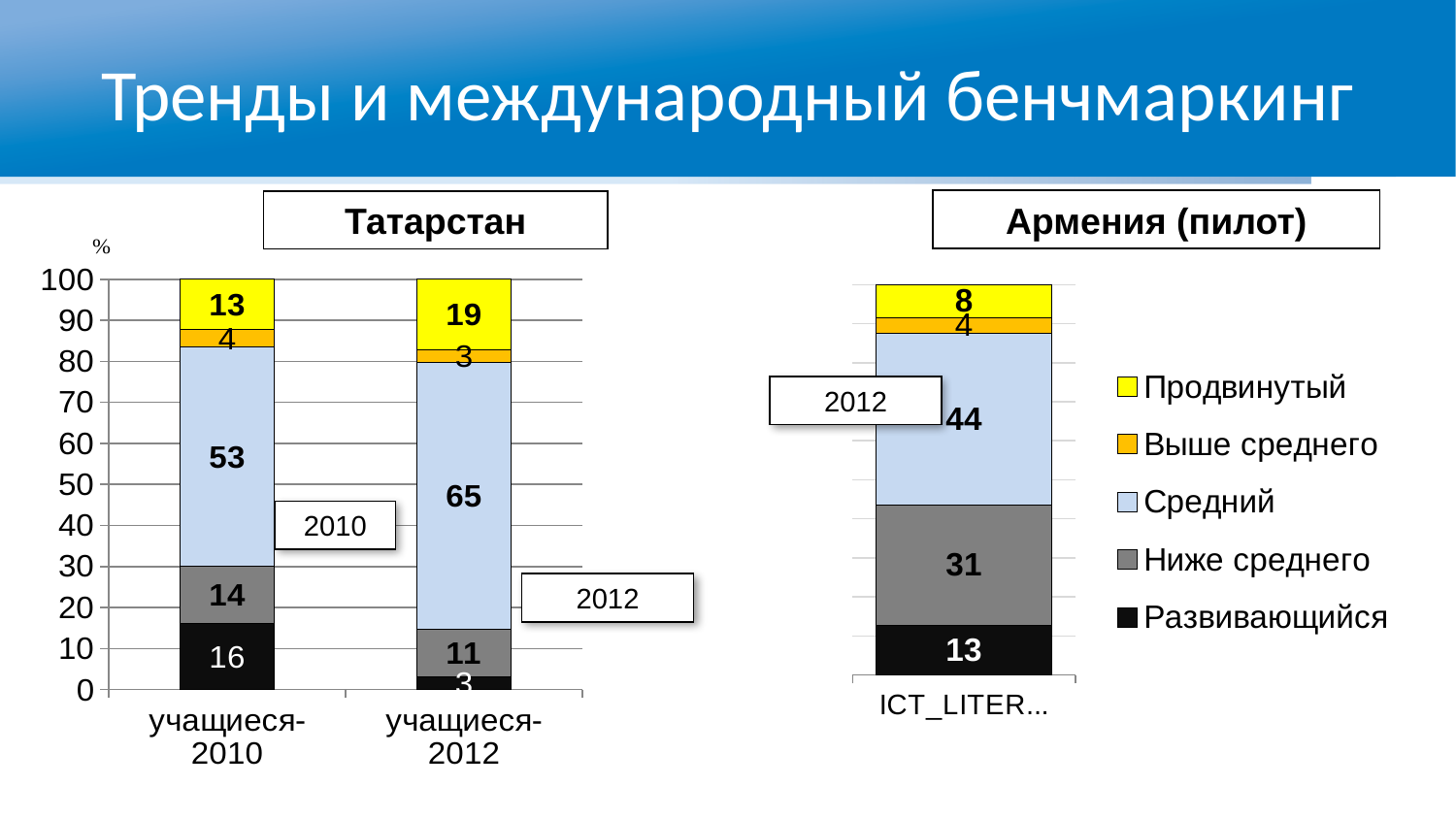
In the Татарстан chart, by how much did the Продвинутый value change from учащиеся-2010 to учащиеся-2012? 6 In the Армения (пилот) chart, what is the value of the Продвинутый segment? 8 In the Татарстан chart, what is the value of the Средний segment for учащиеся-2012? 65 What kind of chart is the Армения (пилот) chart? stacked bar chart In the Татарстан chart, what is the value of the Развивающийся segment for учащиеся-2010? 16 In the Татарстан chart, which is larger: the Ниже среднего value for учащиеся-2010 or for учащиеся-2012? учащиеся-2010 In the Татарстан chart, does the Средний value rise or fall from учащиеся-2010 to учащиеся-2012? rise In the Татарстан chart, which segment is the largest for учащиеся-2010? Средний How many bars are in the Татарстан chart? 2 In the Армения (пилот) chart, what is the value of the Ниже среднего segment? 31 How many series does the legend list? 5 In the Армения (пилот) chart, what is the total of the stacked bar? 100